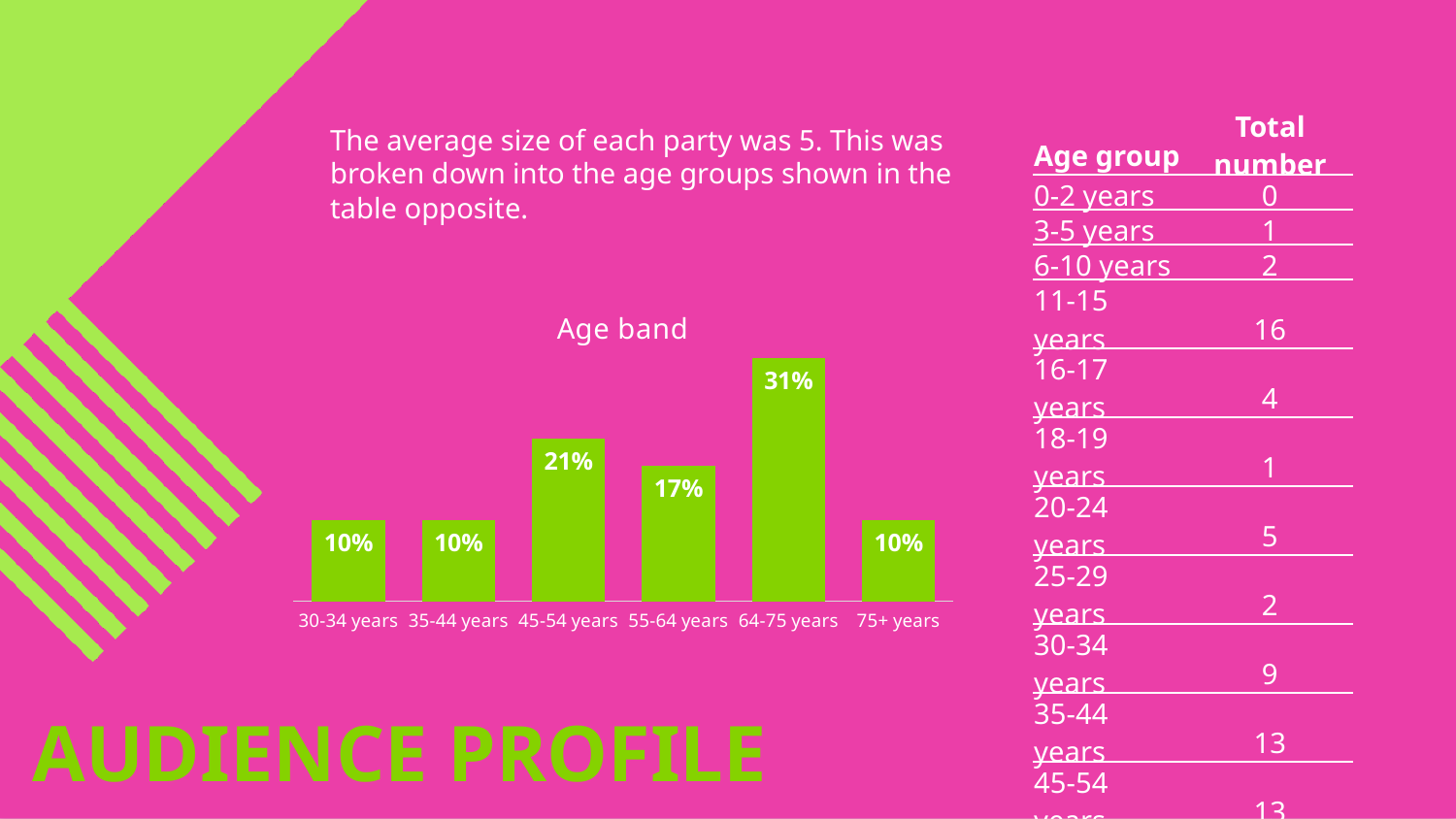
What is the difference between the values for 64-75 years and 55-64 years? 14% What is the title of the chart on the slide? Age band What kind of chart is shown on the slide? bar chart What is the value for the 75+ years age band? 10% What is the value for the 64-75 years age band? 31% What colour are the bars in the chart? green How many age bands are plotted in the chart? 6 Which is larger, the value for 45-54 years or the value for 55-64 years? 45-54 years What is the difference between the values for 45-54 years and 30-34 years? 11% What is the value for the 55-64 years age band? 17% Which age band has the highest value in the chart? 64-75 years What is the value for the 45-54 years age band? 21%